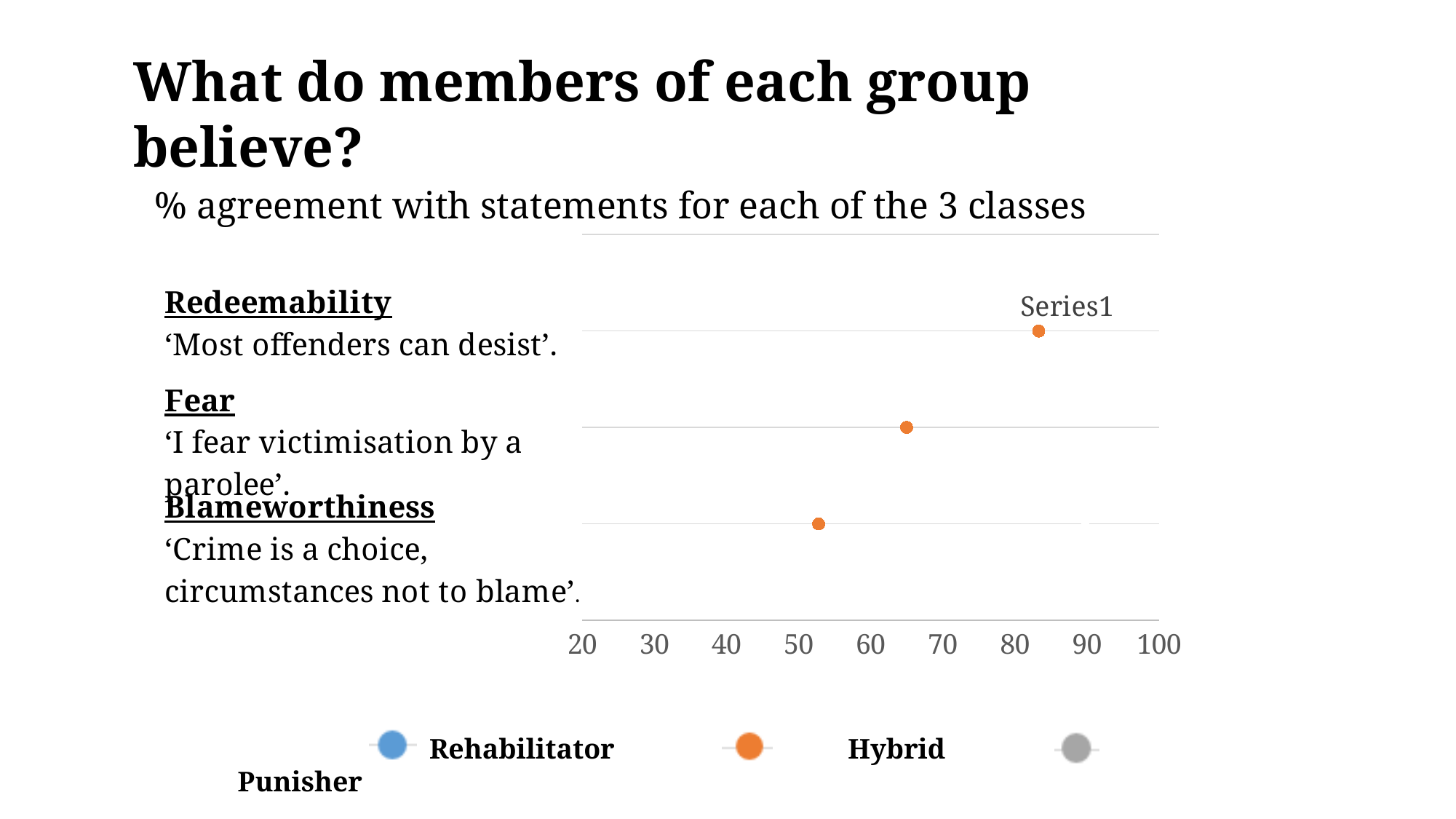
Is the plotted value for Fear greater or less than 70? less Which statement has the lowest plotted % agreement? Blameworthiness What is the lowest value shown on the horizontal axis? 20 How many groups does the legend below the chart list? 3 Which statement has the highest plotted % agreement? Redeemability What colour are the markers for the Hybrid group in the legend? orange What kind of chart is shown on the slide? dot plot Which has the larger plotted value, Fear or Blameworthiness? Fear Is the plotted value for Fear greater or less than 60? greater Is the plotted value for Blameworthiness greater or less than 60? less How many statements (categories) are plotted on the chart? 3